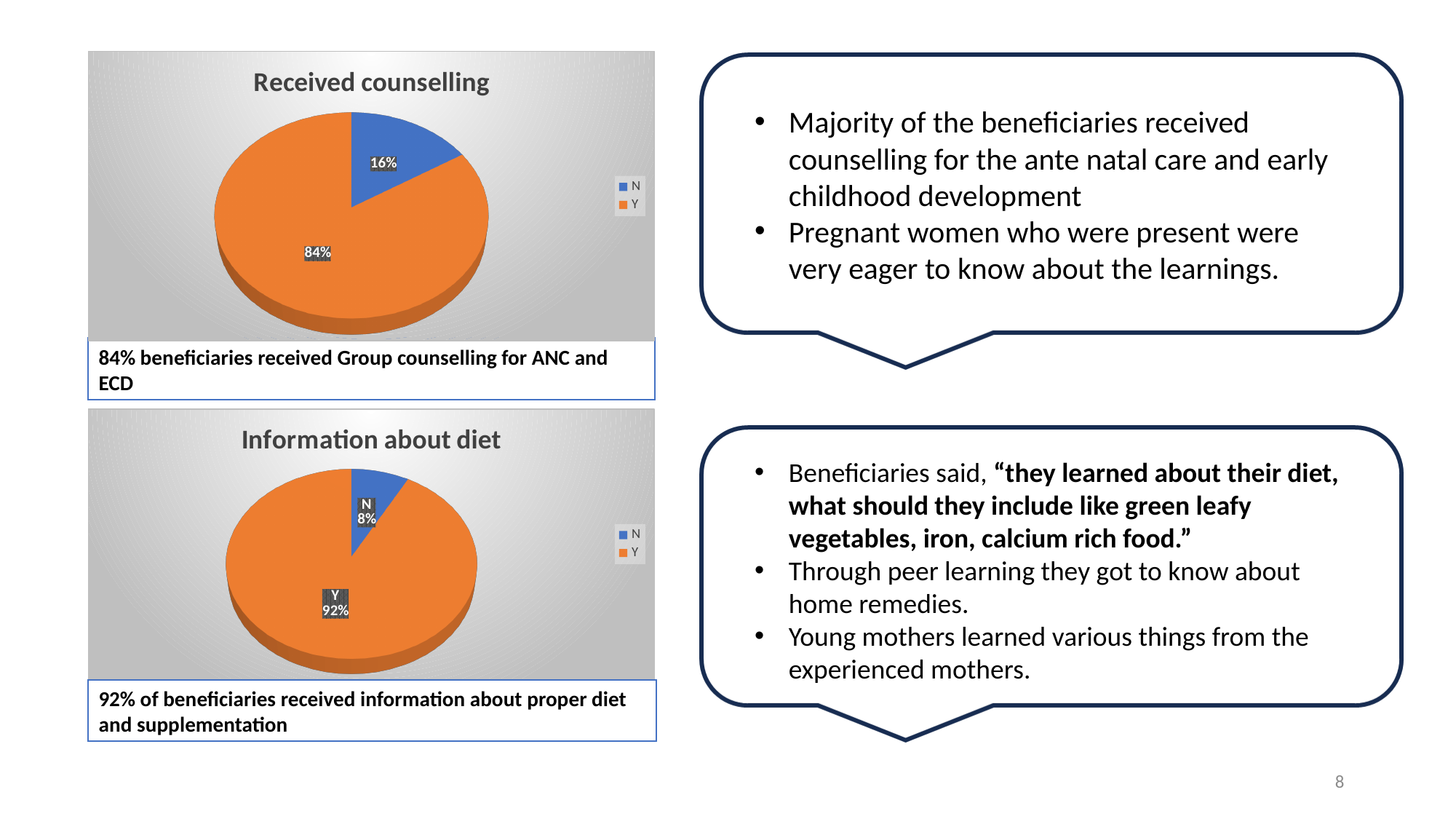
In the 'Received counselling' chart, what percentage is shown for Y? 84% In the 'Received counselling' chart, what percentage is shown for N? 16% In the 'Received counselling' chart, what colour represents Y? Orange In the 'Received counselling' chart, which category has the largest slice? Y How many categories does the legend of the 'Information about diet' chart list? 2 In the 'Information about diet' chart, what is the difference between the Y and N percentages? 84% What type of chart is 'Received counselling'? Pie chart In the 'Information about diet' chart, which category has the smallest slice? N In the 'Information about diet' chart, what percentage is shown for N? 8% Is the N slice larger in the 'Received counselling' chart or the 'Information about diet' chart? Received counselling In the 'Information about diet' chart, what percentage is shown for Y? 92% In the 'Received counselling' chart, what is the difference between the Y and N percentages? 68%